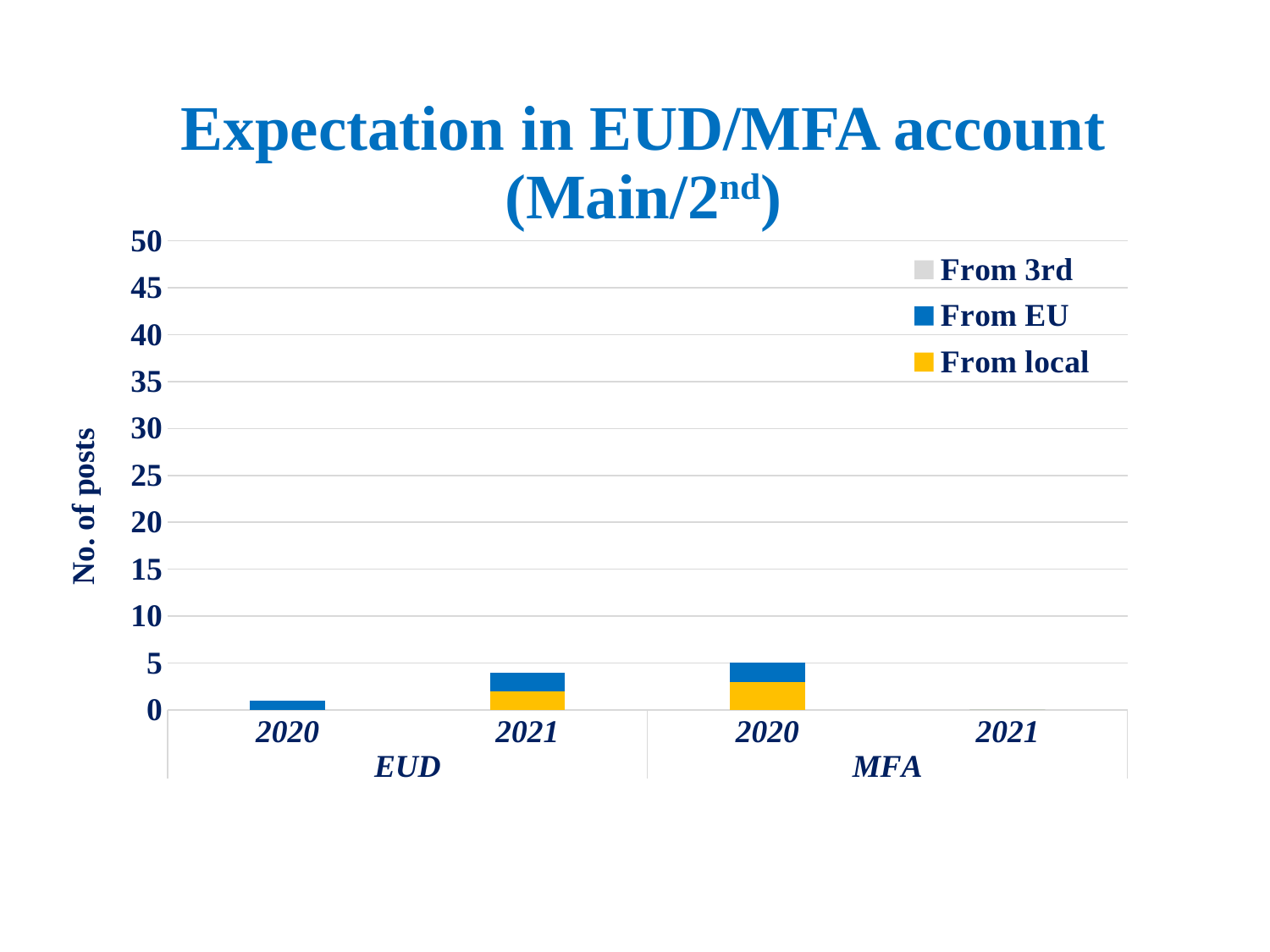
Does the 'From 3rd' series appear in any of the bars? No Which series appears in the EUD 2020 bar? From EU How many year categories are shown along the x axis? 4 Is the total bar for MFA 2020 greater or less than 10? less Is the bar for EUD 2020 greater or less than 5? less Which is larger, the total bar for EUD 2020 or for EUD 2021? EUD 2021 Which category has no bar at all? MFA 2021 What is the title of the chart? Expectation in EUD/MFA account (Main/2nd) What is the label on the vertical axis? No. of posts What kind of chart is shown on the slide? Stacked bar chart How many series does the legend list? 3 Is the total bar for EUD 2021 greater or less than 10? less